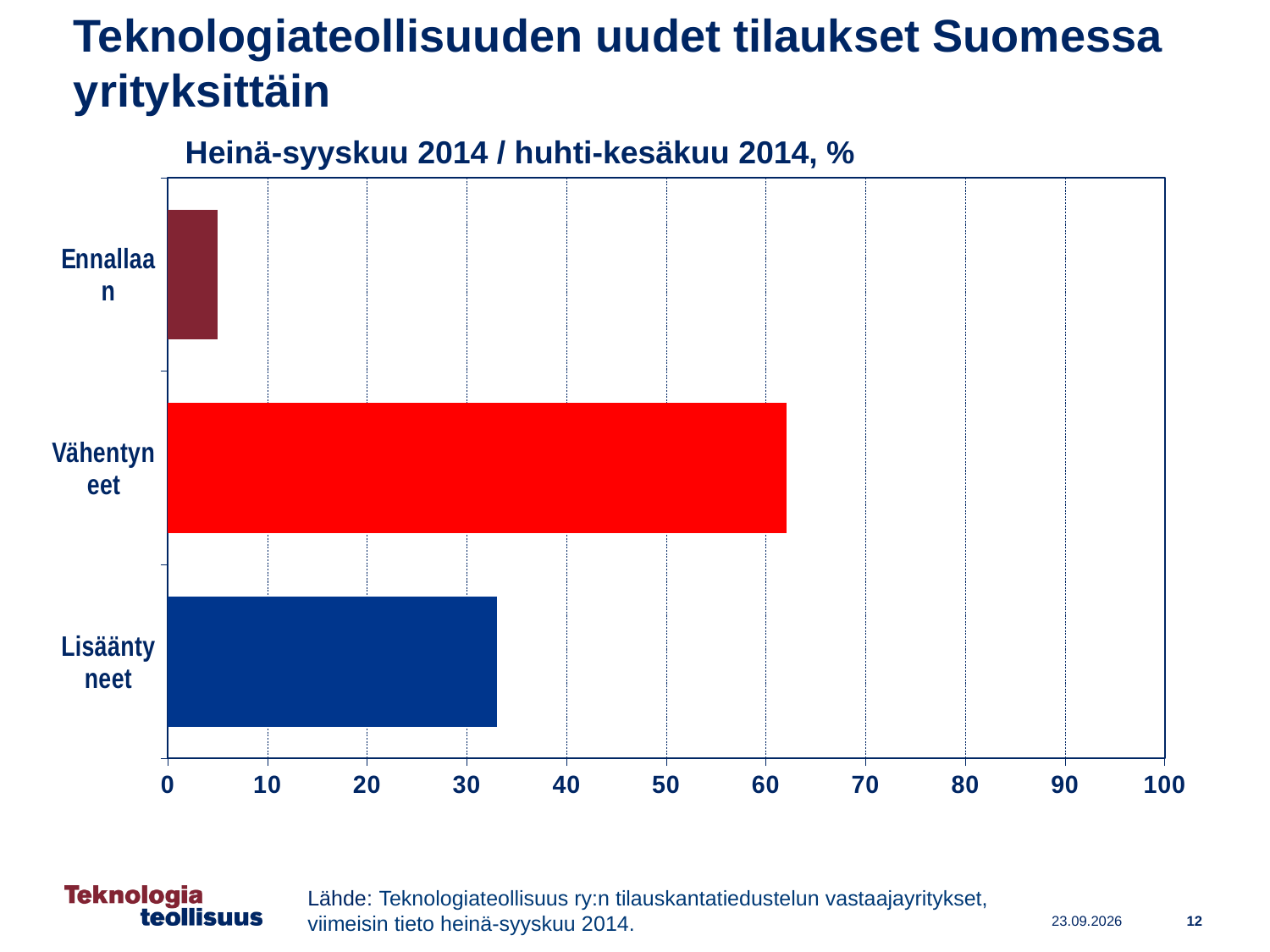
Which is larger, the value for Vähentyneet or the value for Lisääntyneet? Vähentyneet What kind of chart is shown on the slide? bar chart Which category has the lowest value? Ennallaan How many categories are plotted in the chart? 3 Which is larger, the value for Lisääntyneet or the value for Ennallaan? Lisääntyneet Is the value for Vähentyneet greater or less than 50? greater Is the value for Lisääntyneet greater or less than 20? greater Is the value for Lisääntyneet greater or less than 40? less Which category has the highest value? Vähentyneet What is the subtitle shown above the chart? Heinä-syyskuu 2014 / huhti-kesäkuu 2014, % What is the maximum value shown on the horizontal axis? 100